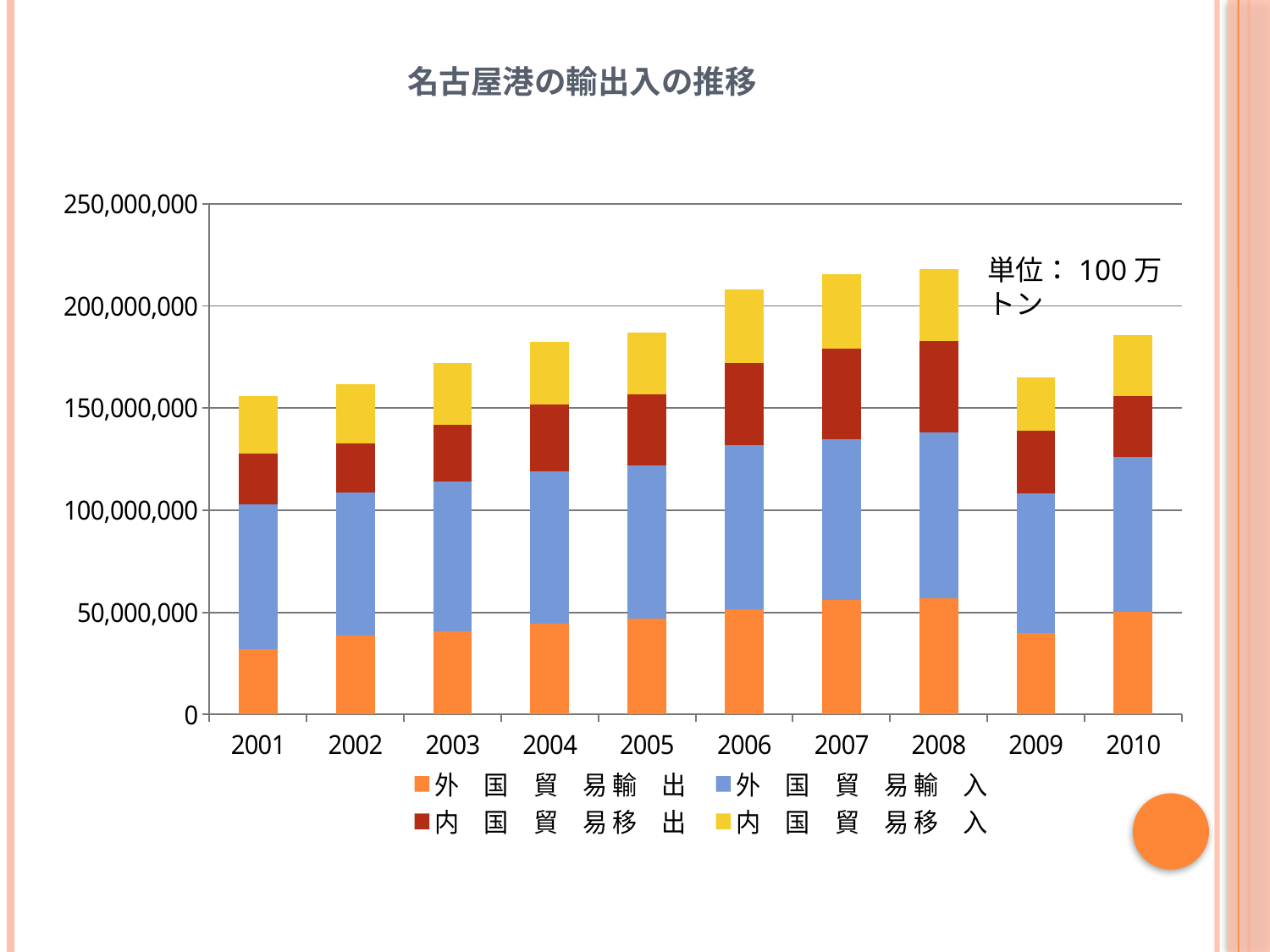
Is the 外国貿易輸出 value for 2008 greater or less than 50,000,000? greater What is the title of the chart? 名古屋港の輸出入の推移 Between 2001 and 2008, do the total stacked bar heights rise or fall? rise How many years are shown on the x axis? 10 What kind of chart is shown on the slide? Stacked bar chart Is the total stacked value for 2009 greater or less than 200,000,000? less Is the total stacked value for 2008 greater or less than 200,000,000? greater How many series does the legend list? 4 Which year has a larger total stacked value, 2008 or 2009? 2008 What unit is stated in the note on the chart? 100万トン